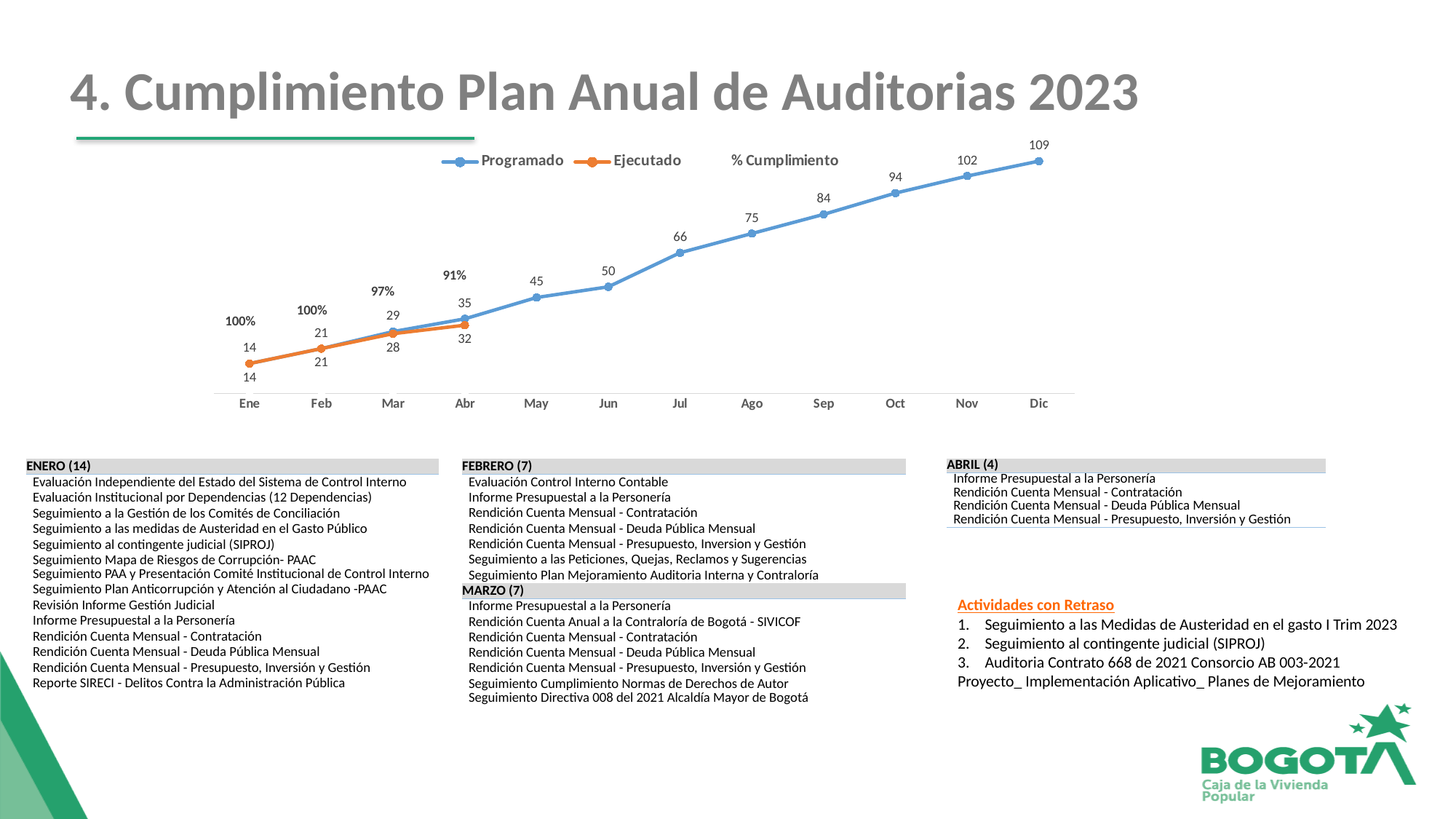
In which month is the Programado value highest? Dic What is the difference between the Programado and Ejecutado values in Abr? 3 Which is larger in Mar, the Programado value or the Ejecutado value? Programado What is the Ejecutado value for Abr? 32 What is the Programado value for Dic? 109 How many series does the chart legend list? 3 In which month is the Programado value lowest? Ene What is the % Cumplimiento shown for Mar? 97% What type of chart is shown on the slide? line chart Does the Programado series rise or fall from Ene to Dic? rise What is the Programado value for Jul? 66 How many months are shown on the x axis of the chart? 12